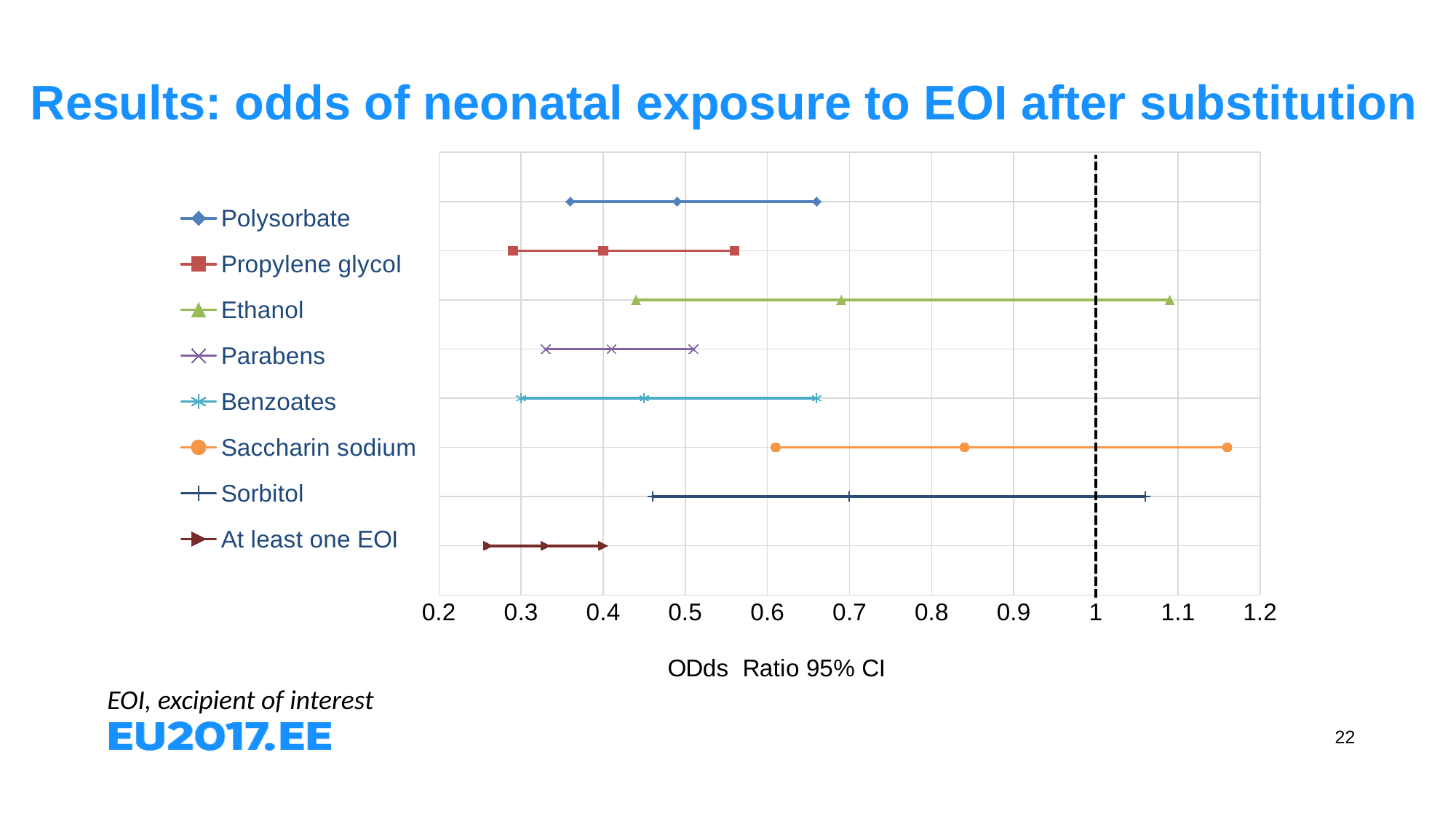
Is the upper confidence limit for Ethanol greater or less than 1? greater How many series does the legend list? 8 At what x-axis value is the vertical dashed reference line drawn? 1 What is the x-axis title of the chart? ODds Ratio 95% CI Is the upper confidence limit for Parabens greater or less than 0.6? less Which series has the lowest central odds ratio estimate? At least one EOI Is the central odds ratio for At least one EOI greater or less than 0.4? less Which has the larger central odds ratio, Polysorbate or Propylene glycol? Polysorbate Which series has the highest central odds ratio estimate? Saccharin sodium Which has the larger upper confidence limit, Saccharin sodium or Benzoates? Saccharin sodium